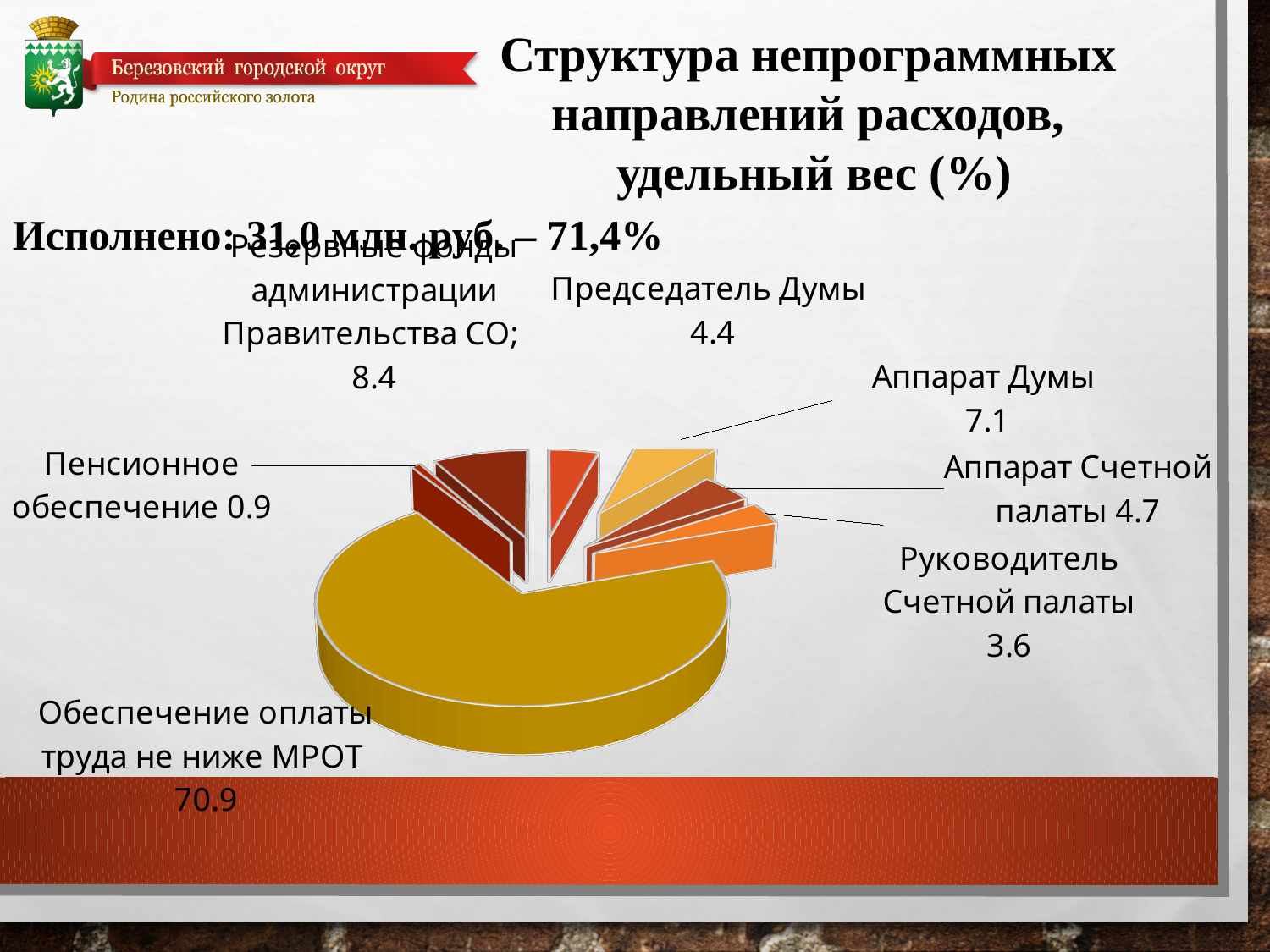
What is the value for Аппарат Думы? 7.1 What share of the pie does Пенсионное обеспечение represent? 0.9 Which category has the smallest share of the pie? Пенсионное обеспечение What is the value for Руководитель Счетной палаты? 3.6 How many categories (slices) does the pie chart show? 7 What is the value for Резервные фонды администрации Правительства СО? 8.4 What is the title of the chart? Структура непрограммных направлений расходов, удельный вес (%) Which is larger, the value for Аппарат Счетной палаты or the value for Председатель Думы? Аппарат Счетной палаты What is the difference between the values for Аппарат Думы and Председатель Думы? 2.7 Which category has the largest share of the pie? Обеспечение оплаты труда не ниже МРОТ What kind of chart is shown on the slide? pie chart What is the value for Обеспечение оплаты труда не ниже МРОТ? 70.9